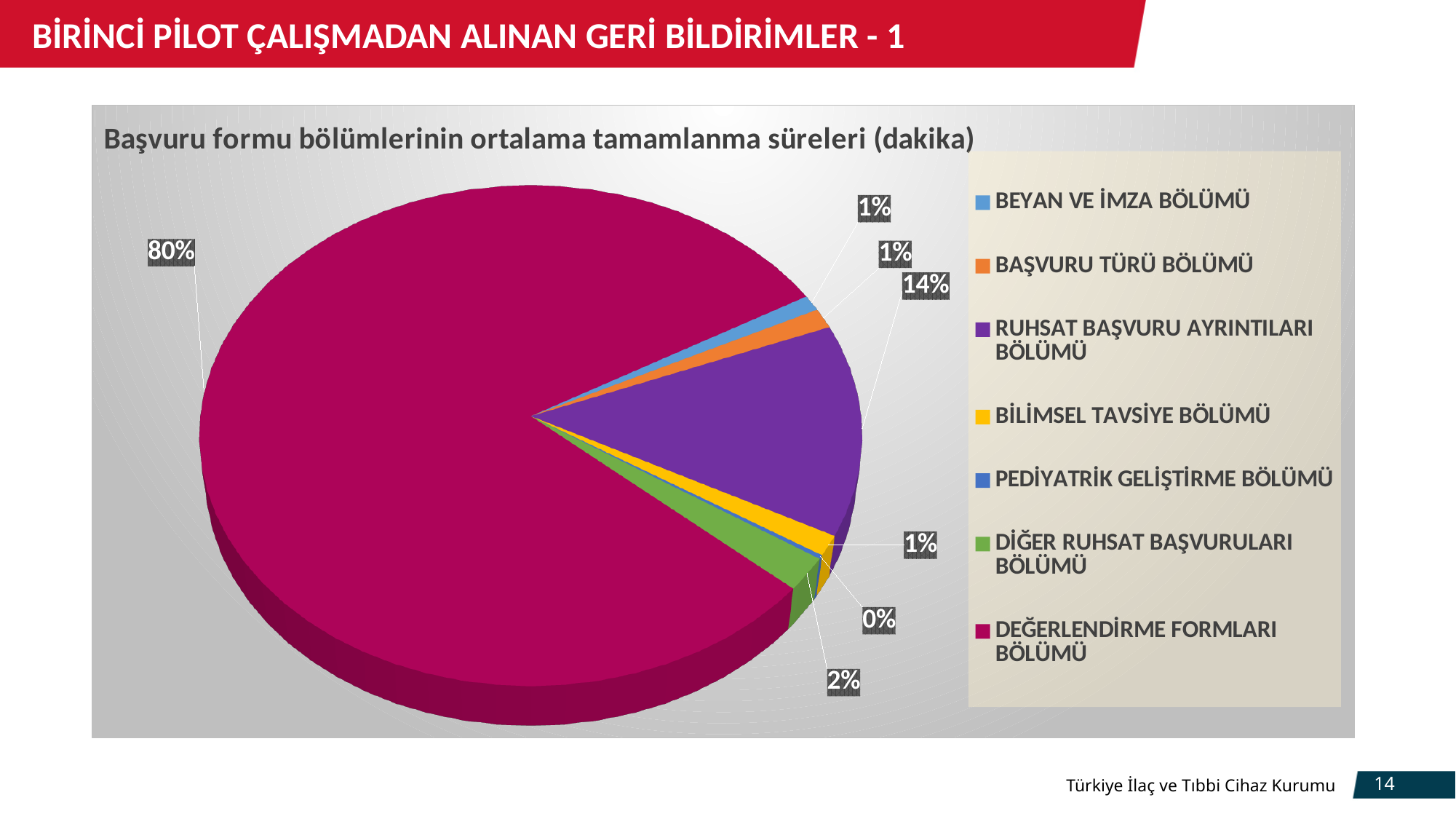
What kind of chart is shown on the slide? pie chart What is the value shown for BİLİMSEL TAVSİYE BÖLÜMÜ? 1% What is the value shown for DİĞER RUHSAT BAŞVURULARI BÖLÜMÜ? 2% What share of the pie does DEĞERLENDİRME FORMLARI BÖLÜMÜ take? 80% How many categories does the legend of the pie chart list? 7 Which category has the smallest slice of the pie? PEDİYATRİK GELİŞTİRME BÖLÜMÜ What is the title of the chart? Başvuru formu bölümlerinin ortalama tamamlanma süreleri (dakika) What is the value shown for PEDİYATRİK GELİŞTİRME BÖLÜMÜ? 0% Which is larger, the slice for RUHSAT BAŞVURU AYRINTILARI BÖLÜMÜ or the slice for DİĞER RUHSAT BAŞVURULARI BÖLÜMÜ? RUHSAT BAŞVURU AYRINTILARI BÖLÜMÜ Which category has the largest slice of the pie? DEĞERLENDİRME FORMLARI BÖLÜMÜ What is the difference in percentage points between DEĞERLENDİRME FORMLARI BÖLÜMÜ and RUHSAT BAŞVURU AYRINTILARI BÖLÜMÜ? 66 What share of the pie does RUHSAT BAŞVURU AYRINTILARI BÖLÜMÜ take? 14%